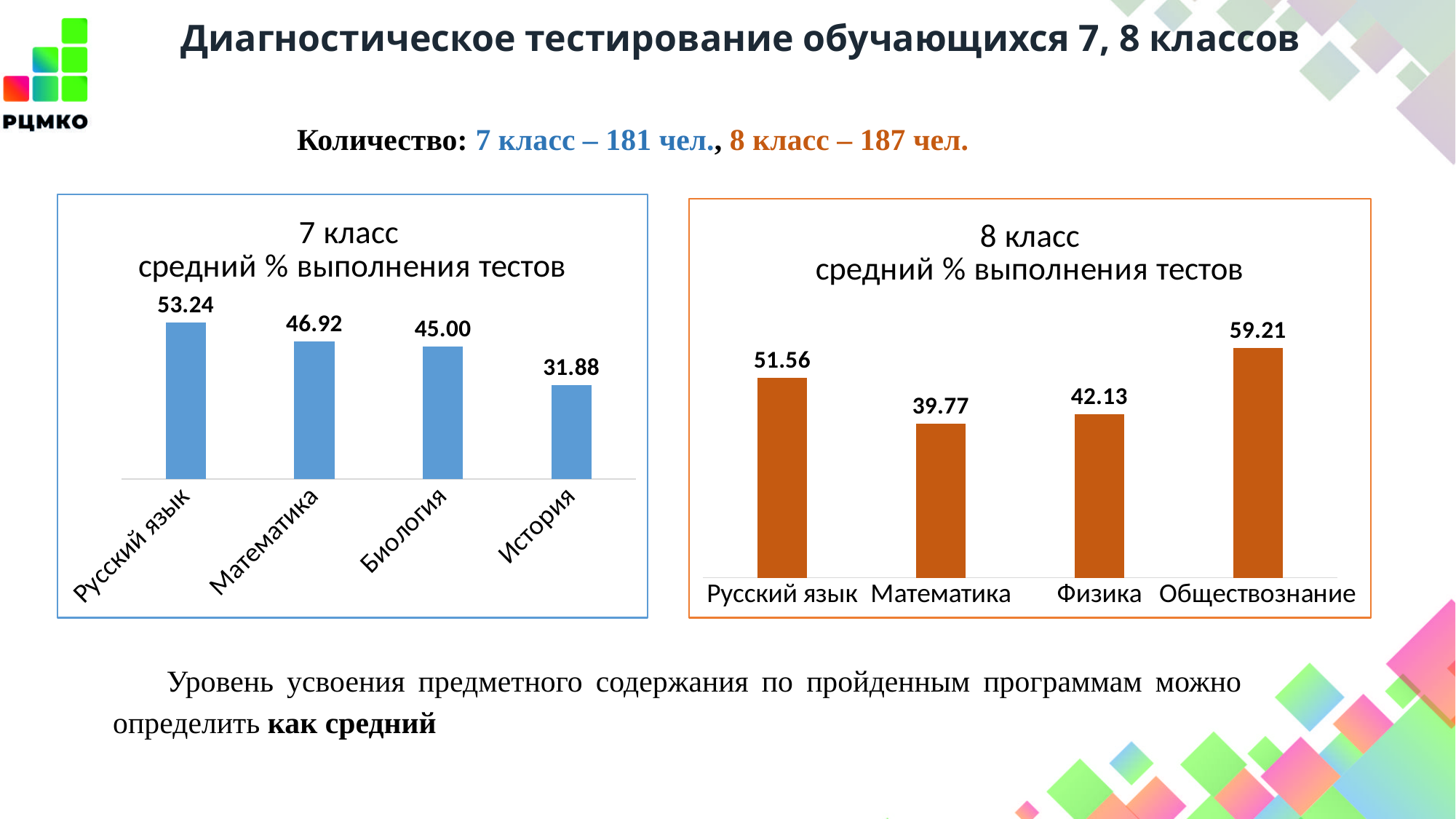
In the chart titled "8 класс средний % выполнения тестов", what is the value for Математика? 39.77 In the chart titled "7 класс средний % выполнения тестов", which category has the lowest value? История In the chart titled "7 класс средний % выполнения тестов", how many categories are shown? 4 In the chart titled "7 класс средний % выполнения тестов", what is the difference between Математика and Биология? 1.92 In the chart titled "8 класс средний % выполнения тестов", what is the value for Физика? 42.13 In the chart titled "7 класс средний % выполнения тестов", do the values rise or fall from left to right? Fall In the chart titled "7 класс средний % выполнения тестов", what is the value for История? 31.88 In the chart titled "8 класс средний % выполнения тестов", which is larger: Русский язык or Физика? Русский язык In the chart titled "8 класс средний % выполнения тестов", which category has the highest value? Обществознание What kind of chart is the chart titled "7 класс средний % выполнения тестов"? Bar chart In the chart titled "8 класс средний % выполнения тестов", what is the difference between Обществознание and Математика? 19.44 In the chart titled "7 класс средний % выполнения тестов", what is the value for Русский язык? 53.24